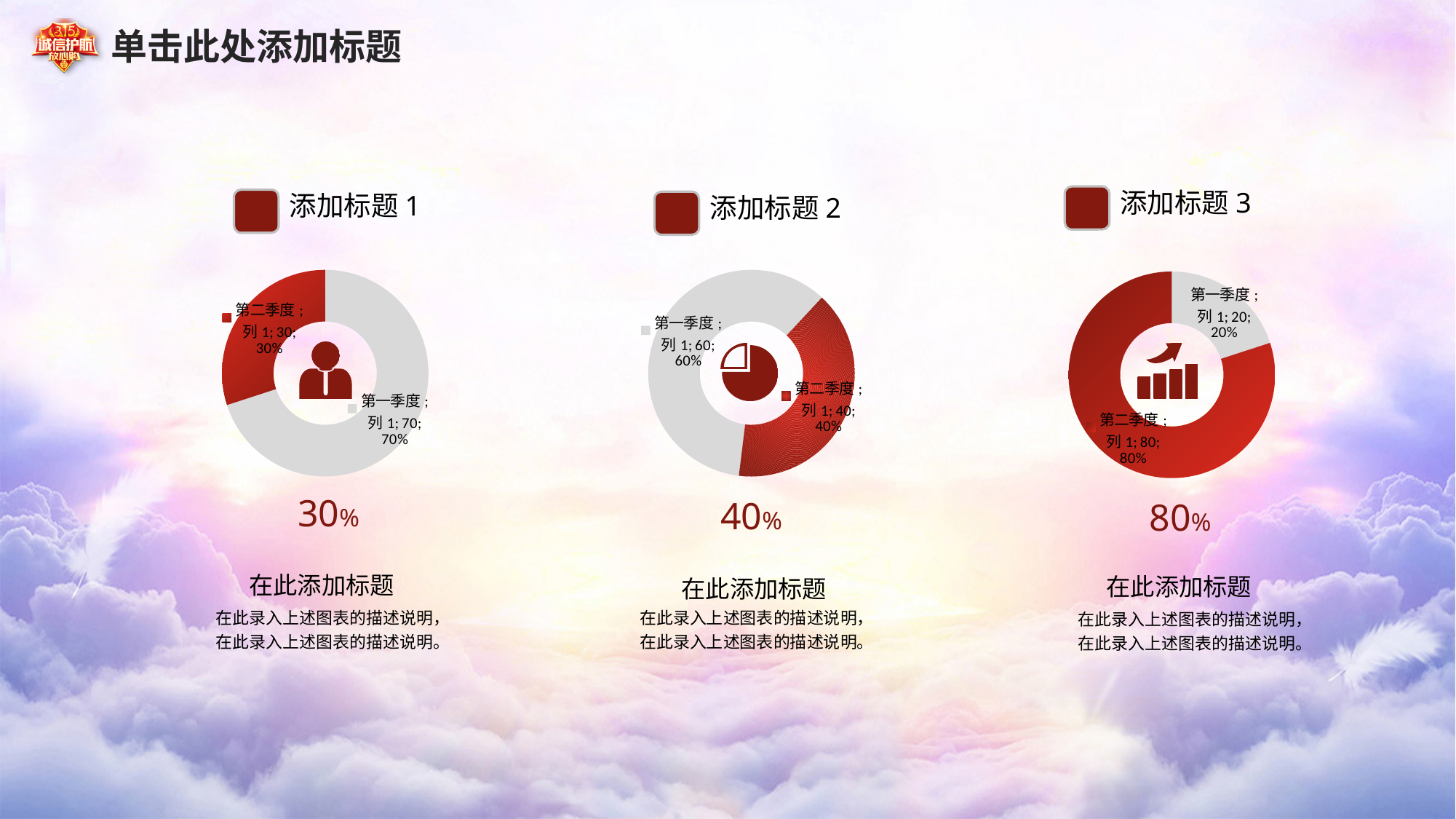
In the chart under 添加标题 1, what is the difference between the values for 第一季度 and 第二季度? 40 In the chart under 添加标题 3, what is the value for 第二季度? 80 In the chart under 添加标题 1, what percentage does 第一季度 account for? 70% In the chart under 添加标题 2, what is the value for 第一季度? 60 In the chart under 添加标题 3, what percentage does 第一季度 account for? 20% How many categories does the chart under 添加标题 2 show? 2 In the chart under 添加标题 2, what percentage does 第二季度 account for? 40% In the chart under 添加标题 1, which category has the largest slice? 第一季度 In the chart under 添加标题 3, which category has the smallest slice? 第一季度 What kind of chart is shown under 添加标题 3? Doughnut chart In the chart under 添加标题 2, which is larger, 第一季度 or 第二季度? 第一季度